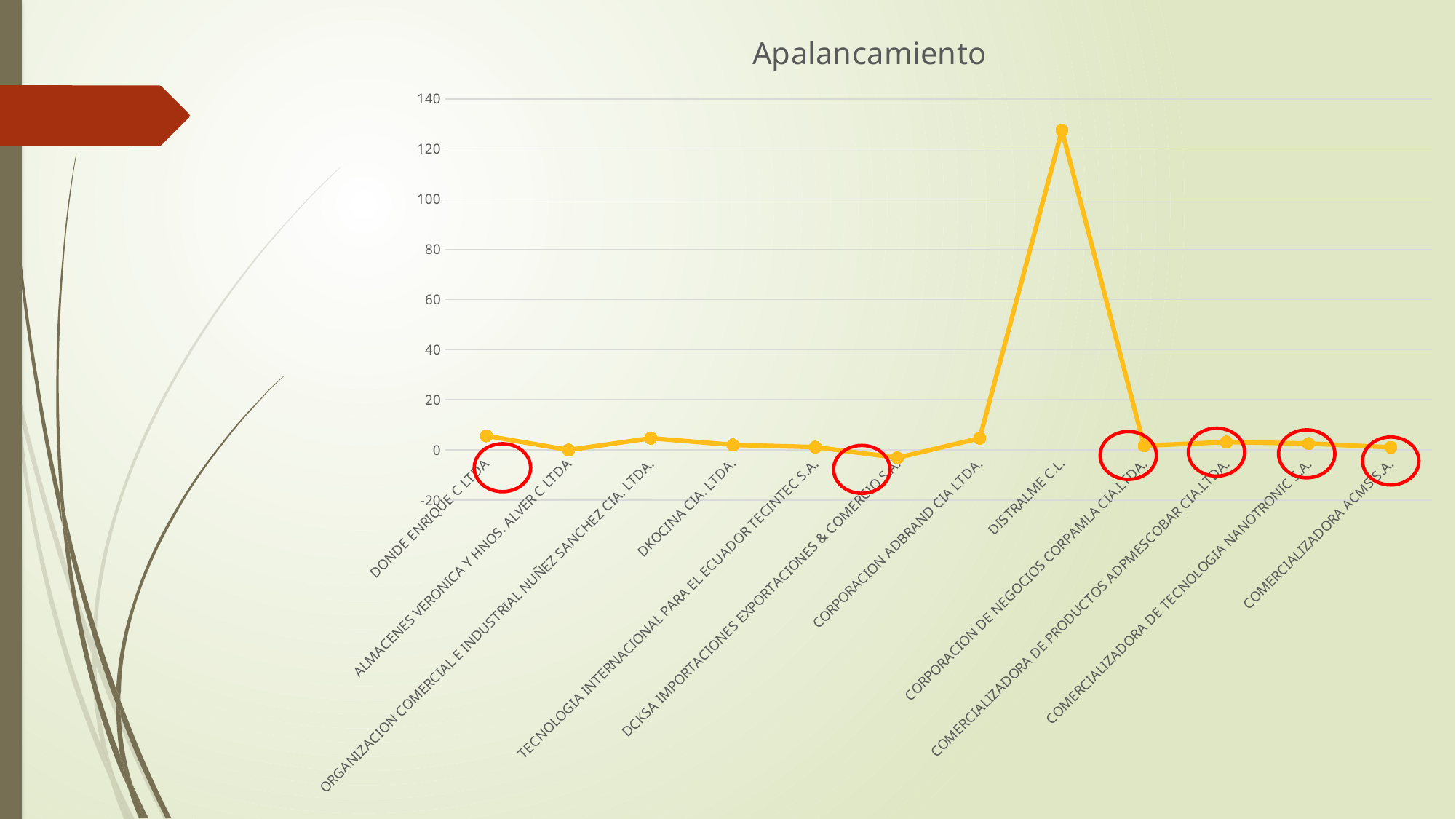
How many companies (categories) are plotted on the x axis? 12 Is the value for DCKSA IMPORTACIONES EXPORTACIONES & COMERCIO S.A. greater or less than 0? less Which has a larger value, DISTRALME C.L. or DKOCINA CIA. LTDA.? DISTRALME C.L. How many red circles are drawn on the chart? 6 Which company has the lowest value in the chart? DCKSA IMPORTACIONES EXPORTACIONES & COMERCIO S.A. Is the value for DISTRALME C.L. greater or less than 140? less Is the value for DISTRALME C.L. greater or less than 120? greater Which has a larger value, DONDE ENRIQUE C LTDA or DCKSA IMPORTACIONES EXPORTACIONES & COMERCIO S.A.? DONDE ENRIQUE C LTDA Which company has the highest value in the chart? DISTRALME C.L. What is the title of the chart? Apalancamiento What type of chart is shown on the slide? line chart